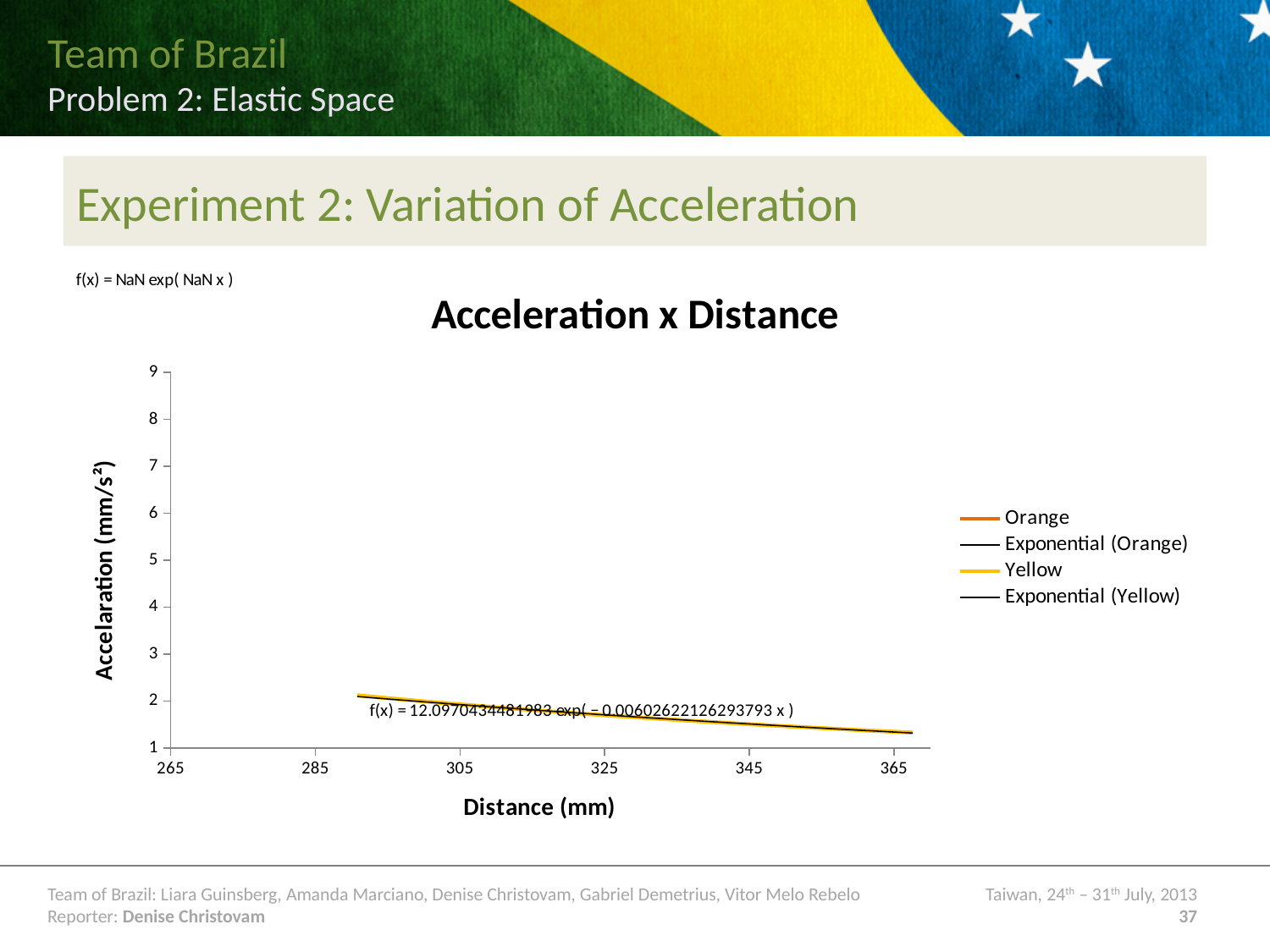
Is the value of the Yellow series at a distance of 305 mm greater or less than 4? less Which legend entry is listed first? Orange What is the highest value shown on the y axis? 9 What kind of chart is shown on the slide? line chart How many series does the chart's legend list? 4 Is the value of the Yellow series at a distance of 365 mm greater or less than 3? less What is the lowest distance value shown on the x axis? 265 Do the plotted values rise or fall as distance increases along the x axis? fall